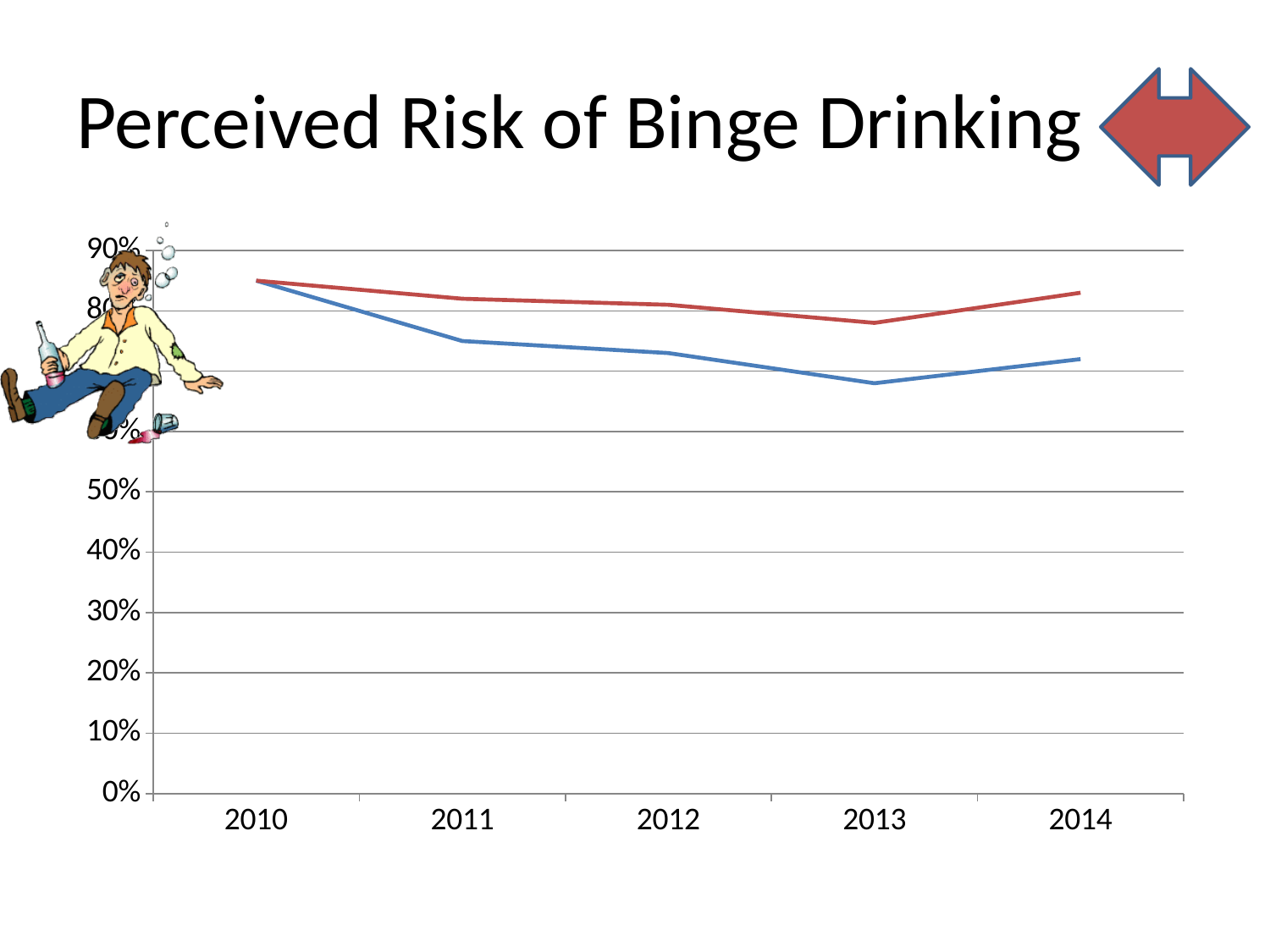
How many years are shown on the x axis of the chart? 5 In which year does the red line reach its lowest value? 2013 In which year does the blue line reach its lowest value? 2013 Which year is the first on the x axis? 2010 What is the title of the chart? Perceived Risk of Binge Drinking Is the value of the blue line in 2011 greater or less than 80%? less Is the value of the red line in 2010 greater or less than 80%? greater Does the blue line rise or fall from 2010 to 2013? fall Which line is higher in 2012, the red line or the blue line? red line How many lines are plotted on the chart? 2 What kind of chart is shown on the slide? line chart In which year is the blue line at its highest value? 2010